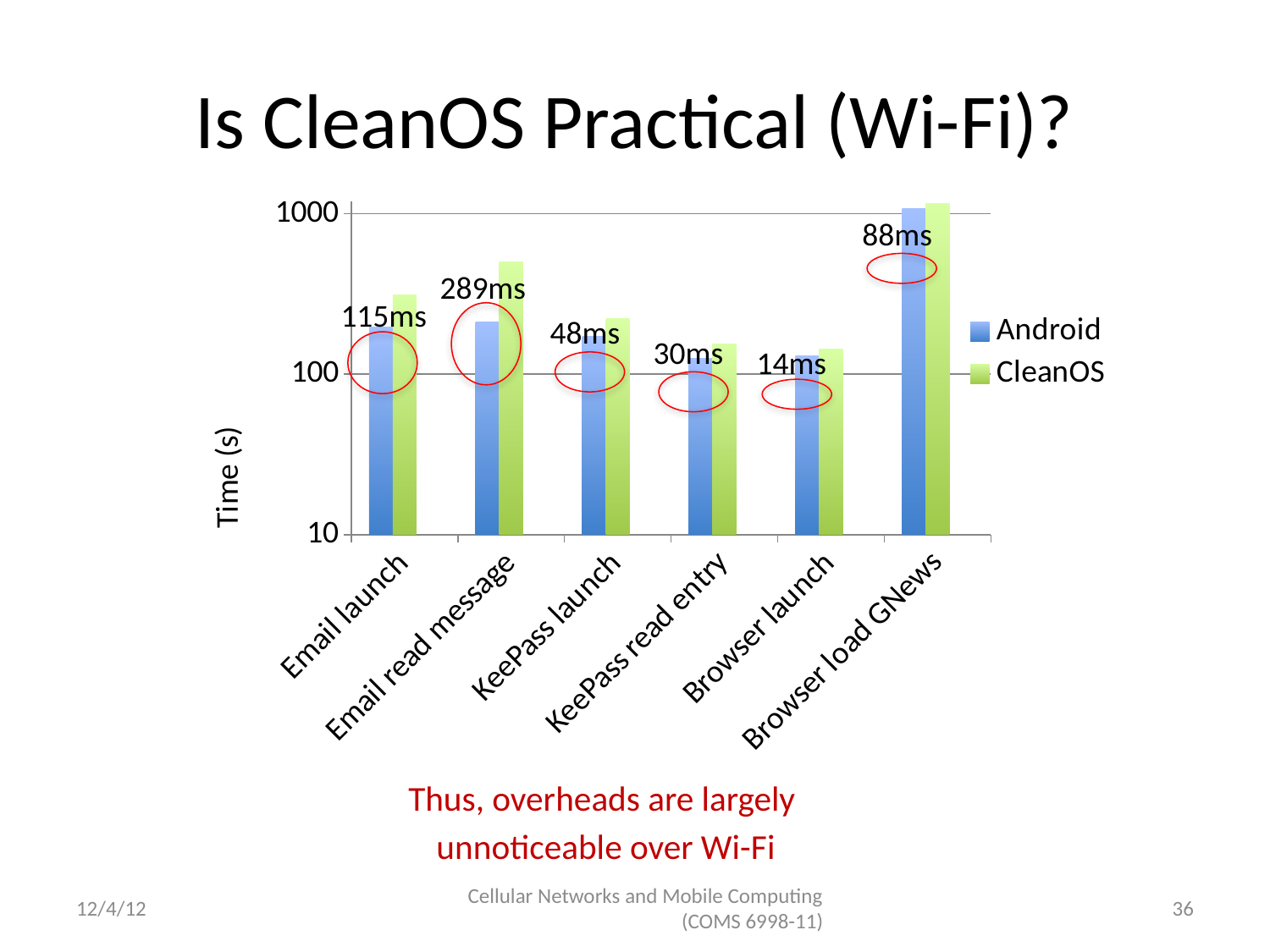
Is the CleanOS value for Email read message greater or less than 100? greater What kind of chart is shown on the slide? bar chart How many categories are shown on the x axis of the chart? 6 Which is larger, the CleanOS value for Email read message or the CleanOS value for Email launch? Email read message How many series does the chart's legend list? 2 Is the Android value for Email launch greater or less than 100? greater Is the CleanOS value for KeePass launch greater or less than 1000? less Which two series are listed in the chart's legend? Android and CleanOS Which is larger for Email read message, the Android value or the CleanOS value? CleanOS What overhead is annotated above the bars for Email read message? 289ms What is the title of the slide containing the chart? Is CleanOS Practical (Wi-Fi)? Which category has the highest values for both Android and CleanOS? Browser load GNews